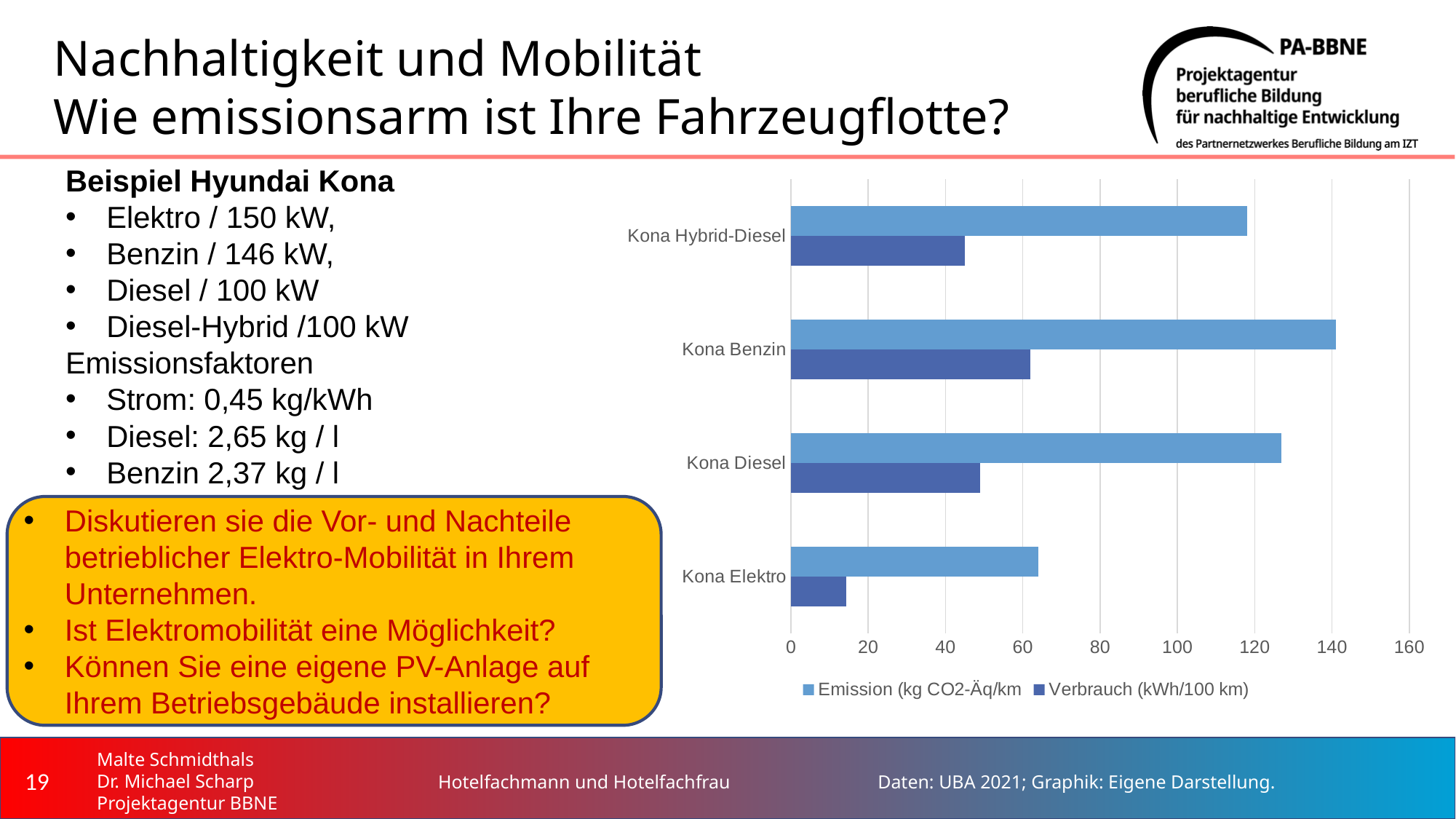
How many series does the chart legend list? 2 Which vehicle has the lowest Emission (kg CO2-Äq/km) value? Kona Elektro Which vehicle has the highest Emission (kg CO2-Äq/km) value? Kona Benzin Which vehicle has the highest Verbrauch (kWh/100 km) value? Kona Benzin How many vehicle categories are shown on the chart? 4 Is the Verbrauch value for Kona Elektro greater or less than 20? less What are the two series named in the chart legend? Emission (kg CO2-Äq/km) and Verbrauch (kWh/100 km) Which vehicle has the lowest Verbrauch (kWh/100 km) value? Kona Elektro Which is larger, the Emission value for Kona Diesel or the Emission value for Kona Elektro? Kona Diesel Is the Emission value for Kona Hybrid-Diesel greater or less than 100? greater What kind of chart is shown on the slide? bar chart